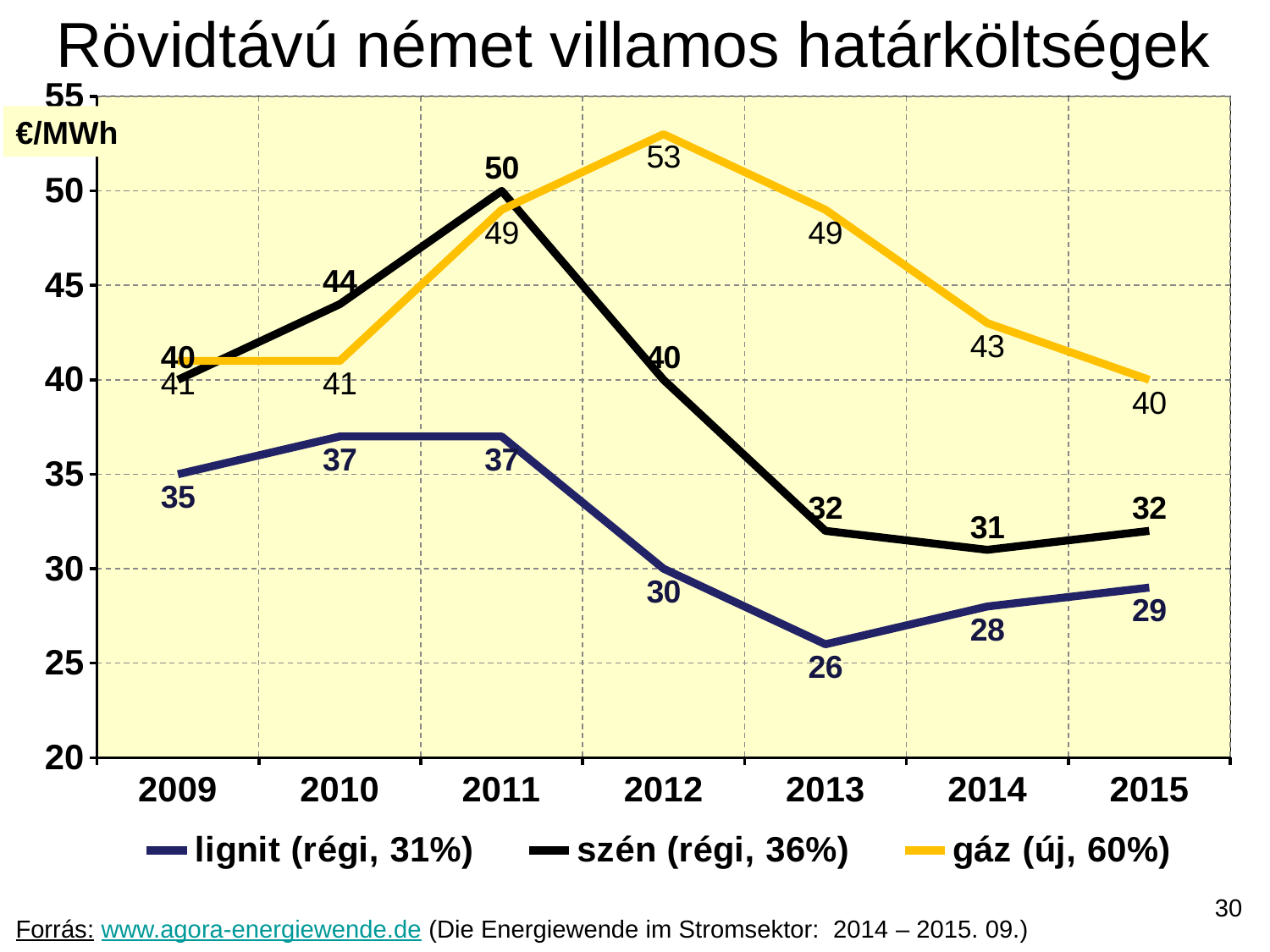
In which year is the gáz (új, 60%) series at its highest? 2012 Which is larger in 2011: the value for szén (régi, 36%) or gáz (új, 60%)? szén (régi, 36%) What is the value for gáz (új, 60%) in 2012? 53 What type of chart is shown on the slide? line chart How many series does the legend list? 3 What is the value for lignit (régi, 31%) in 2013? 26 Does the szén (régi, 36%) series rise or fall from 2011 to 2013? fall What unit is shown in the label at the top left of the plot area? €/MWh What is the difference between the gáz (új, 60%) and szén (régi, 36%) values in 2013? 17 How many years are shown on the x axis? 7 What is the value for szén (régi, 36%) in 2011? 50 In which year is the lignit (régi, 31%) series at its lowest? 2013